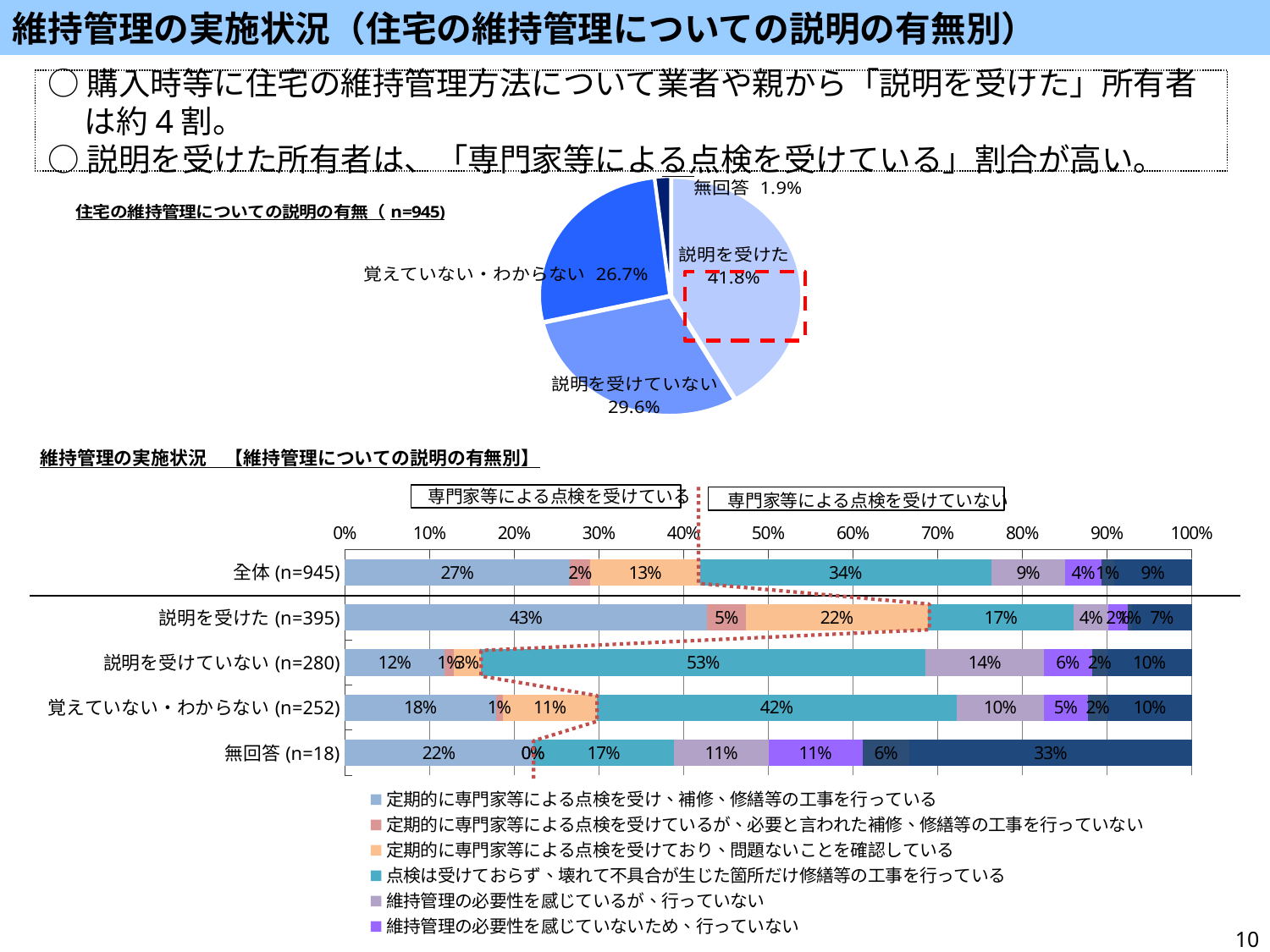
In the pie chart 住宅の維持管理についての説明の有無, what is the share for 無回答? 1.9% In the bar chart 維持管理の実施状況【維持管理についての説明の有無別】, which category has the higher value for 定期的に専門家等による点検を受け、補修、修繕等の工事を行っている: 全体 (n=945) or 説明を受けた (n=395)? 説明を受けた (n=395) In the bar chart 維持管理の実施状況【維持管理についての説明の有無別】, how many categories (rows) are plotted? 5 In the bar chart 維持管理の実施状況【維持管理についての説明の有無別】, what is the value of 定期的に専門家等による点検を受け、補修、修繕等の工事を行っている for 説明を受けた (n=395)? 43% In the bar chart 維持管理の実施状況【維持管理についての説明の有無別】, what is the value of 点検は受けておらず、壊れて不具合が生じた箇所だけ修繕等の工事を行っている for 説明を受けていない (n=280)? 53% In the pie chart 住宅の維持管理についての説明の有無, which slice is the smallest? 無回答 What kind of chart is the upper chart titled 住宅の維持管理についての説明の有無? pie chart In the pie chart 住宅の維持管理についての説明の有無, how many percentage points larger is 説明を受けた than 説明を受けていない? 12.2% What kind of chart is the lower chart titled 維持管理の実施状況【維持管理についての説明の有無別】? bar chart In the pie chart 住宅の維持管理についての説明の有無, what sample size (n) is shown in the title? n=945 In the pie chart 住宅の維持管理についての説明の有無, which slice is the largest? 説明を受けた In the pie chart 住宅の維持管理についての説明の有無, what is the share for 説明を受けた? 41.8%